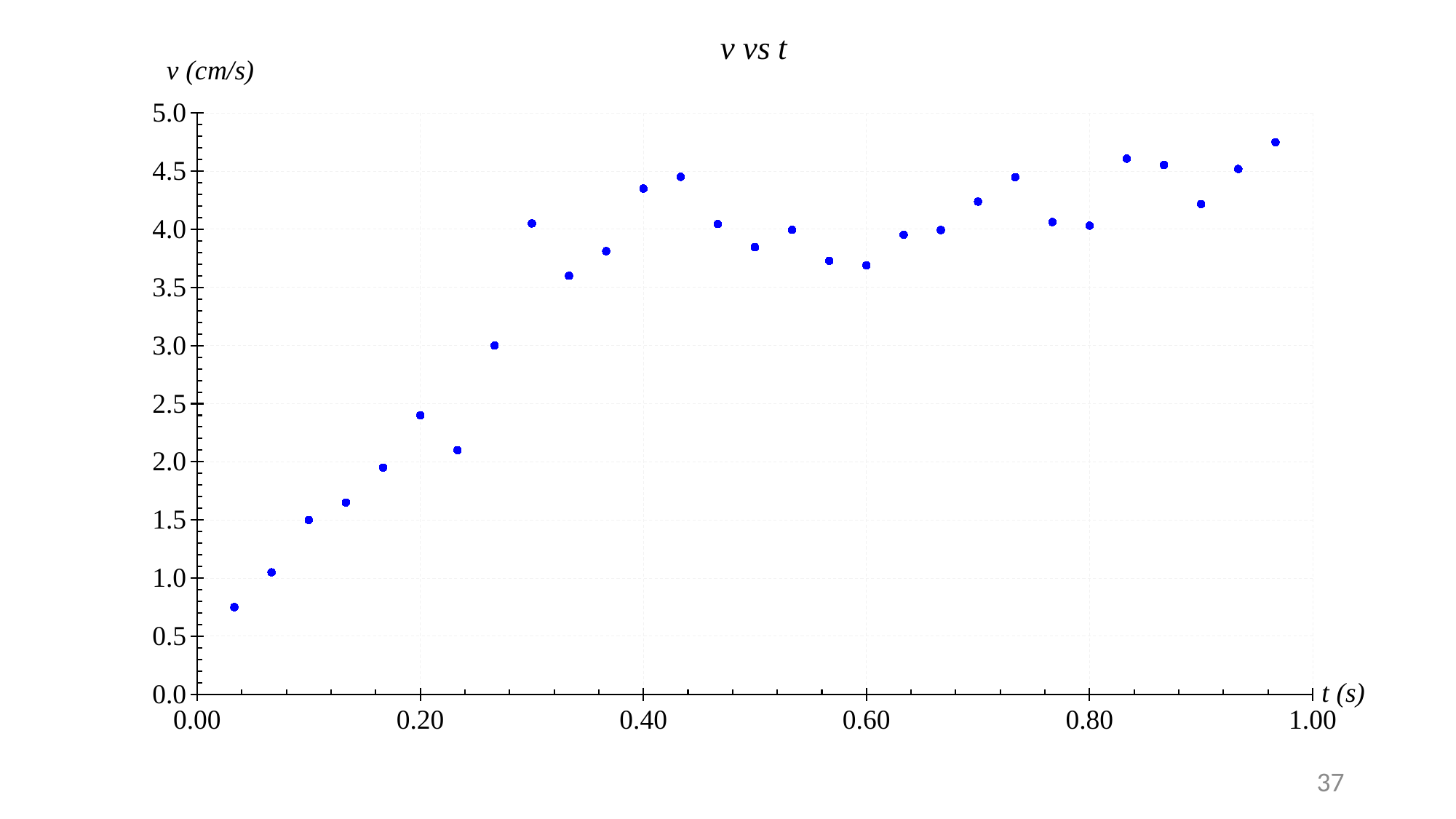
Is the value of v at t = 0.60 s greater or less than 3.5? greater Is the lowest v value found at the start or at the end of the time range? start Is the value of v at t = 0.20 s greater or less than 2.0? greater How many data points are plotted on the chart? 29 What kind of chart is shown on the slide? scatter plot Which is larger, the value of v at t = 0.20 s or at t = 0.40 s? t = 0.40 s Which is larger, the value of v at t = 0.40 s or at t = 0.60 s? t = 0.40 s Is the value of v at t = 0.40 s greater or less than 4.0? greater What is the title of the chart? v vs t Overall, do the v values rise or fall as t increases along the x axis? rise What is the label on the vertical axis of the chart? v (cm/s)